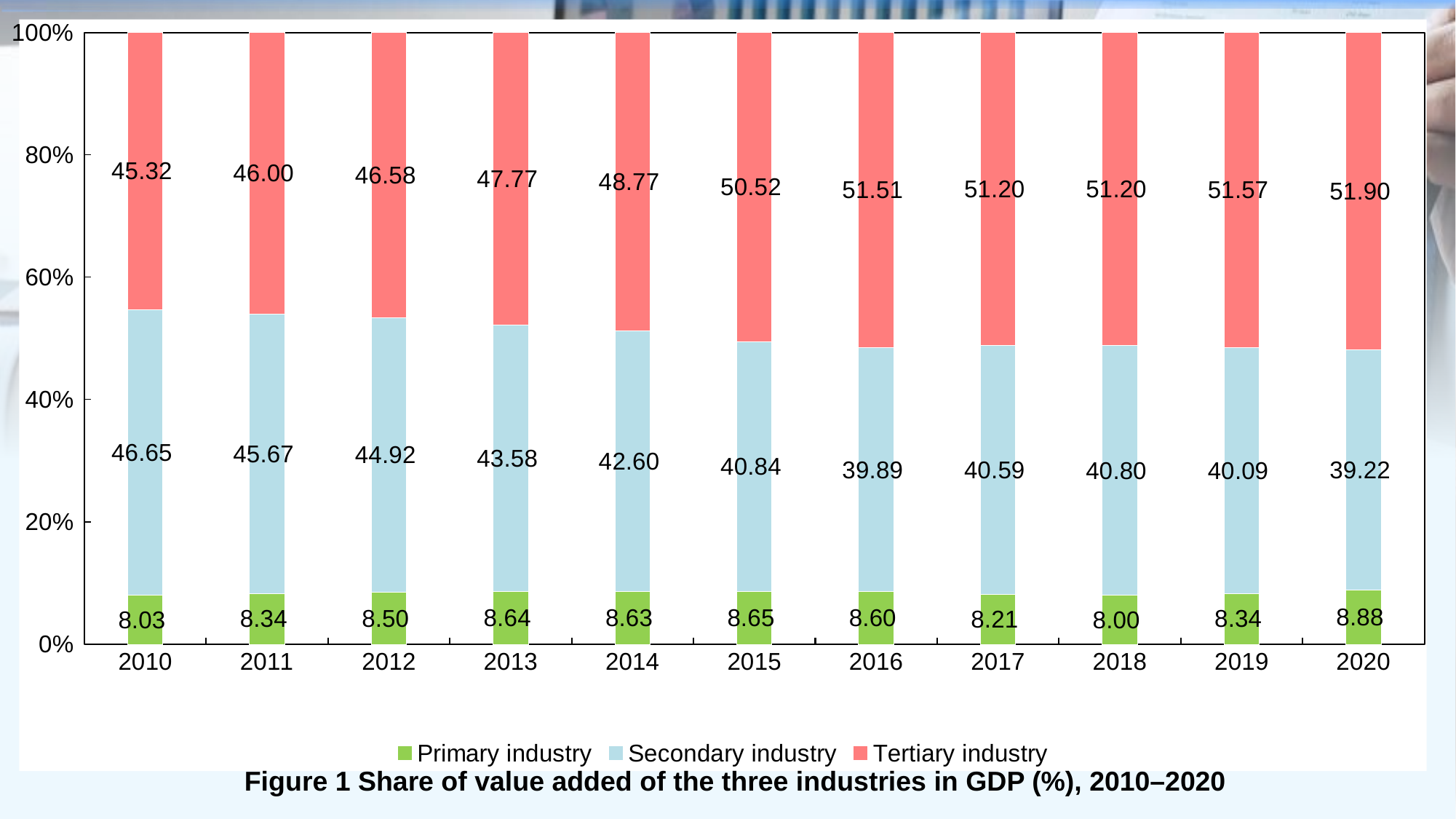
In 2010, which is larger: Secondary industry or Tertiary industry? Secondary industry In which year is the Primary industry share lowest? 2018 In which year is the Tertiary industry share highest? 2020 What is the value for Tertiary industry in 2015? 50.52 What is the value for Secondary industry in 2013? 43.58 Does the Secondary industry share generally rise or fall from 2010 to 2020? Fall What is the value for Primary industry in 2020? 8.88 In which year is the Secondary industry share lowest? 2020 What is the difference between the Tertiary industry value in 2020 and in 2010? 6.58 How many years are shown on the x axis? 11 What kind of chart is shown on the slide? Stacked bar chart How many series does the legend list? 3